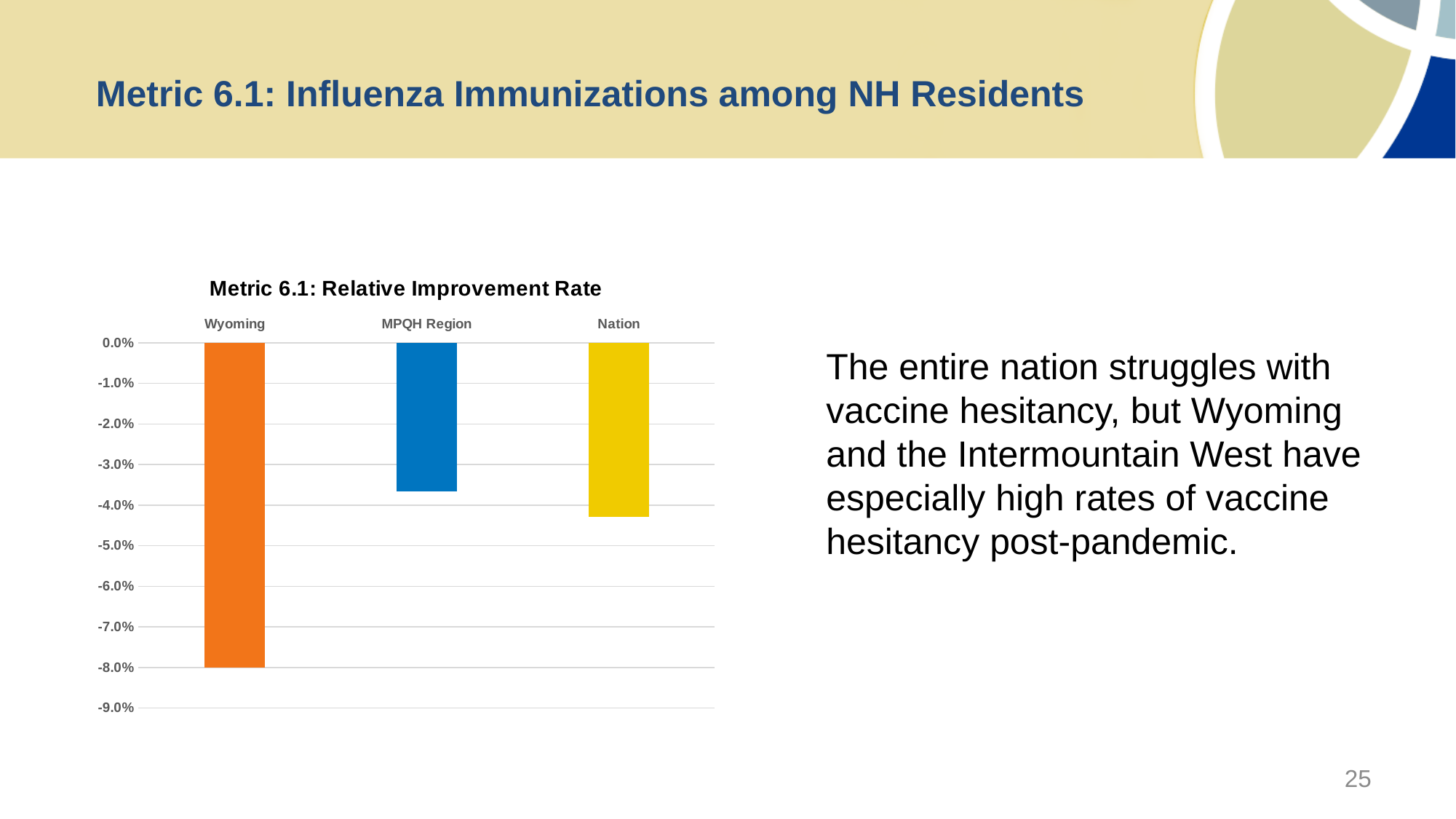
Which has the higher relative improvement rate, Wyoming or Nation? Nation Which category has the lowest (most negative) relative improvement rate? Wyoming How many categories are plotted in the chart? 3 What is the title of the chart? Metric 6.1: Relative Improvement Rate What kind of chart is shown on the slide? bar chart Is the value for Nation greater or less than -4.0%? less What colour is the bar for Wyoming? orange Is the value for MPQH Region greater or less than -3.0%? less What is the relative improvement rate for Wyoming? -8.0% Is the value for Wyoming greater or less than -5.0%? less Which category has the highest (least negative) relative improvement rate? MPQH Region